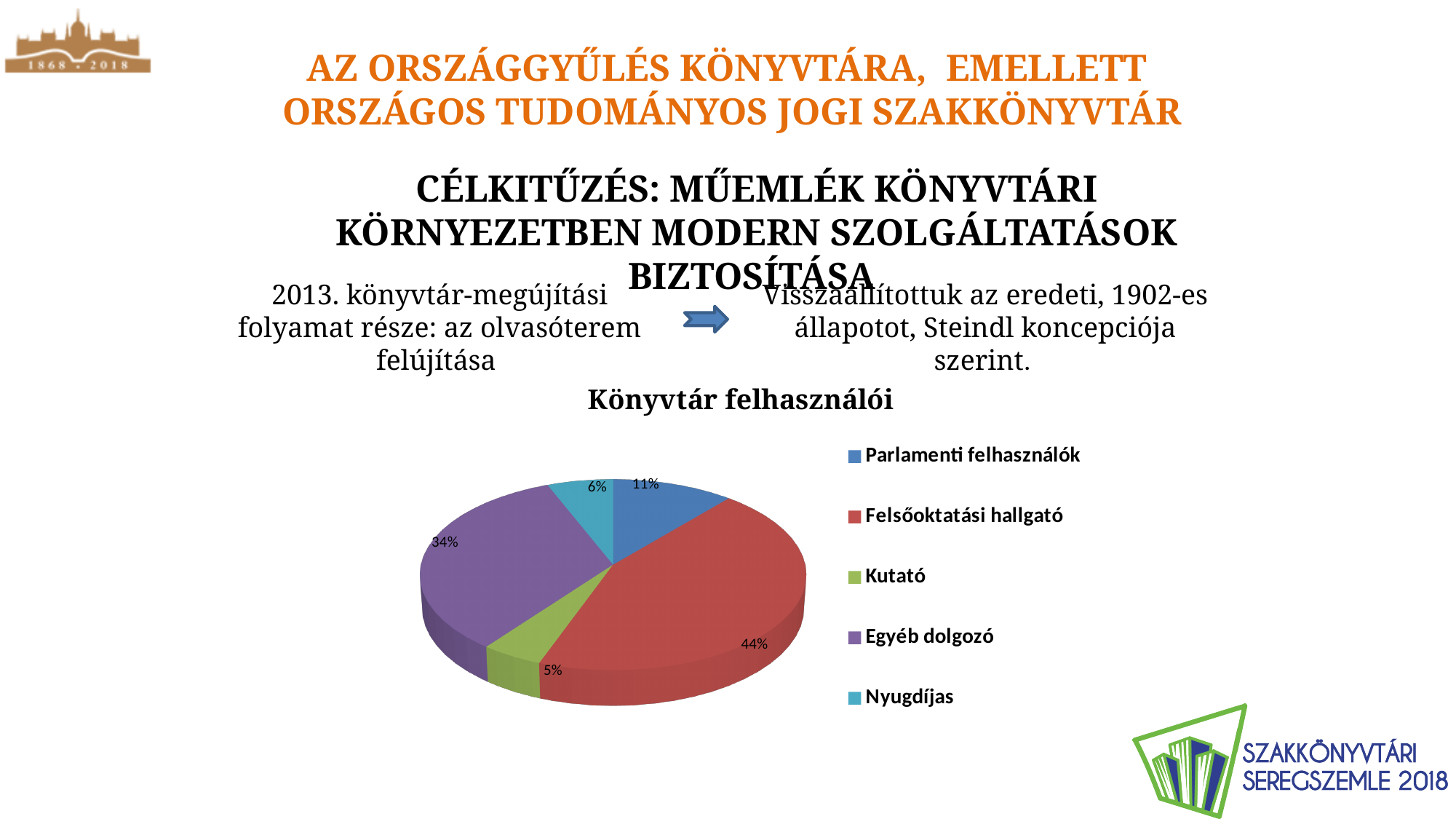
What share of the pie does Kutató have? 5% What is the title of the chart? Könyvtár felhasználói What share of the pie does Egyéb dolgozó have? 34% What type of chart is shown on the slide? pie chart Which category has the largest slice of the pie? Felsőoktatási hallgató Which is larger, the share for Parlamenti felhasználók or the share for Nyugdíjas? Parlamenti felhasználók What share of the pie does Parlamenti felhasználók have? 11% How many categories does the legend list? 5 Which category has the smallest slice of the pie? Kutató What is the difference in percentage points between Felsőoktatási hallgató and Egyéb dolgozó? 10